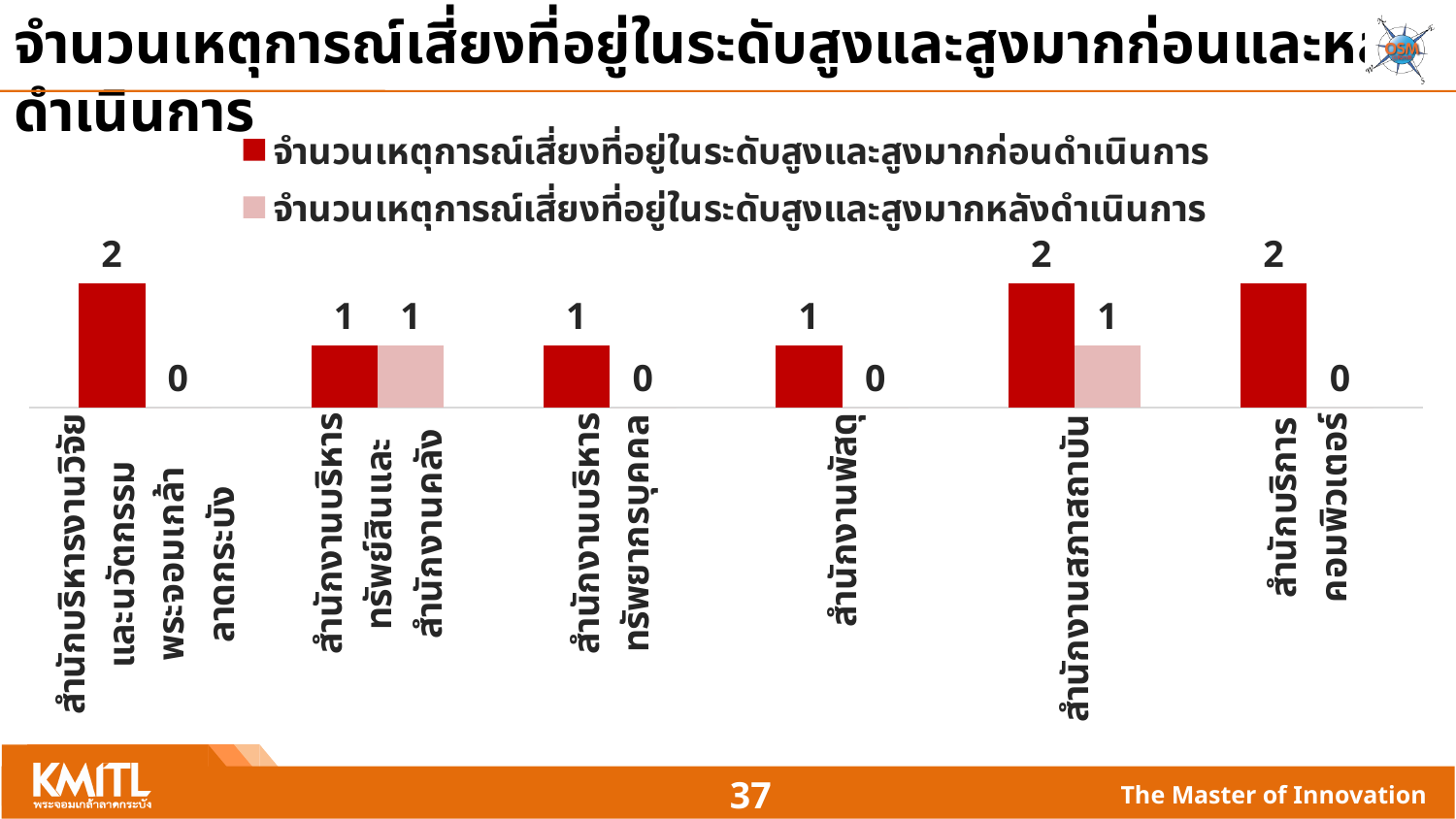
How many categories have a value of 0 in the series จำนวนเหตุการณ์เสี่ยงที่อยู่ในระดับสูงและสูงมากหลังดำเนินการ? 4 What is the value for สำนักงานพัสดุ in the series จำนวนเหตุการณ์เสี่ยงที่อยู่ในระดับสูงและสูงมากก่อนดำเนินการ? 1 What colour are the bars for the series จำนวนเหตุการณ์เสี่ยงที่อยู่ในระดับสูงและสูงมากก่อนดำเนินการ? dark red How many categories (offices) are shown on the x axis? 6 What is the value for สำนักบริการคอมพิวเตอร์ in the series จำนวนเหตุการณ์เสี่ยงที่อยู่ในระดับสูงและสูงมากหลังดำเนินการ? 0 Which is larger for สำนักบริการคอมพิวเตอร์: the before (ก่อนดำเนินการ) value or the after (หลังดำเนินการ) value? before (ก่อนดำเนินการ) What is the value for สำนักงานสภาสถาบัน in the series จำนวนเหตุการณ์เสี่ยงที่อยู่ในระดับสูงและสูงมากหลังดำเนินการ? 1 What is the difference between the before (ก่อนดำเนินการ) and after (หลังดำเนินการ) values for สำนักงานสภาสถาบัน? 1 How many series does the legend list? 2 What is the value for สำนักบริหารงานวิจัยและนวัตกรรมพระจอมเกล้าลาดกระบัง in the series จำนวนเหตุการณ์เสี่ยงที่อยู่ในระดับสูงและสูงมากก่อนดำเนินการ? 2 Which is larger for สำนักงานบริหารทรัพย์สินและสำนักงานคลัง: the before (ก่อนดำเนินการ) value or the after (หลังดำเนินการ) value? They are equal (both 1) What kind of chart is shown on the slide? bar chart